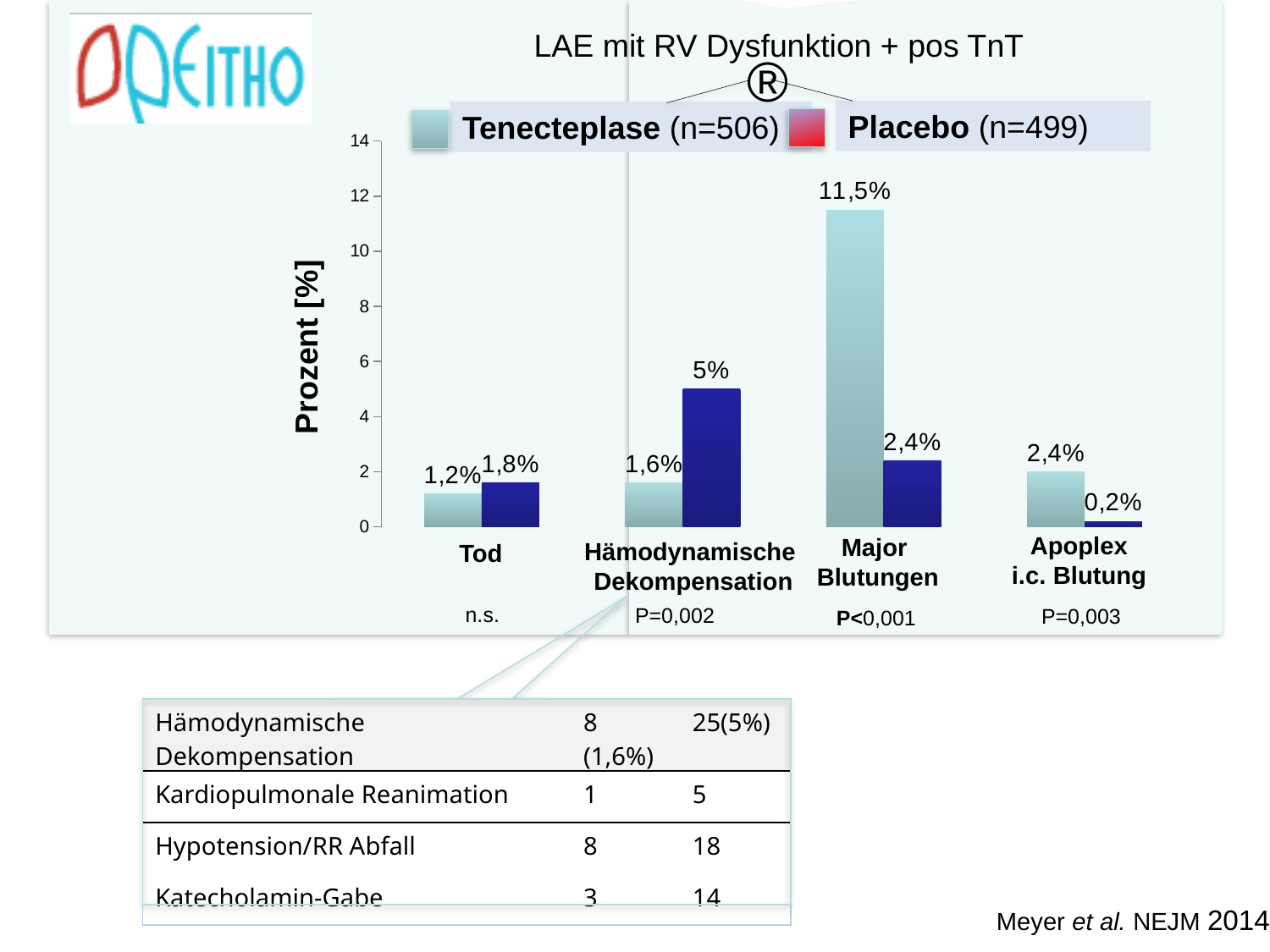
What is the Placebo value for Hämodynamische Dekompensation? 5% What is the Tenecteplase value for Major Blutungen? 11,5% Is the Tenecteplase value for Major Blutungen greater or less than 10? greater How many series does the chart legend list? 2 How many categories are shown on the x axis of the chart? 4 Which category has the lowest Placebo value? Apoplex i.c. Blutung Which category has the highest Tenecteplase value? Major Blutungen For Hämodynamische Dekompensation, which is larger: the Tenecteplase value or the Placebo value? Placebo What is the difference between the Tenecteplase and Placebo values for Major Blutungen? 9,1% What is the Placebo value for Apoplex i.c. Blutung? 0,2% What type of chart is shown on the slide? bar chart What is the Tenecteplase value for Tod? 1,2%